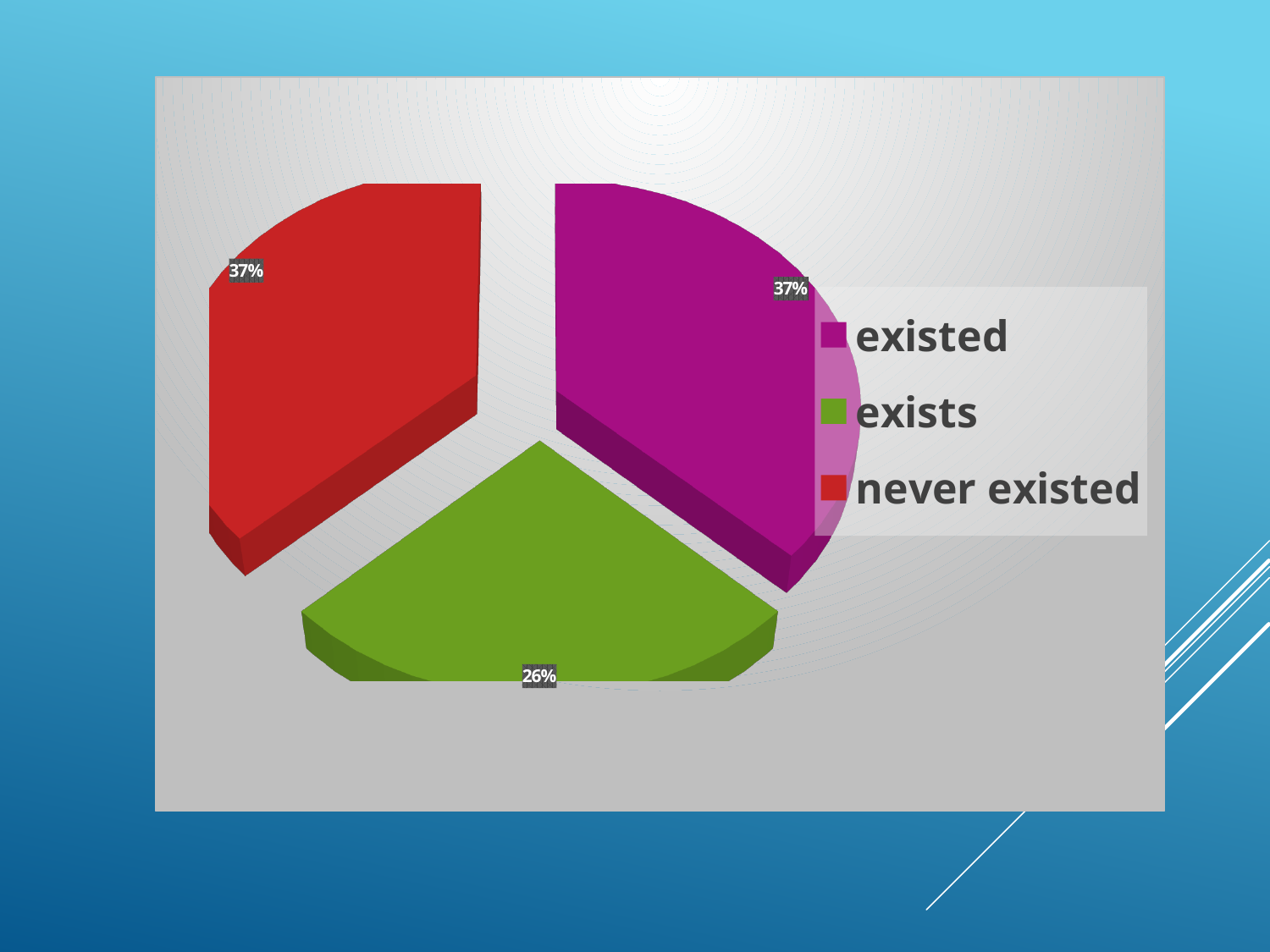
Which category has the smallest slice of the pie? exists Which is larger, the "existed" slice or the "exists" slice? existed What share of the pie does the "never existed" slice represent? 37% How many slices does the pie chart have? 3 What kind of chart is shown on the slide? pie chart Which is larger, the "never existed" slice or the "exists" slice? never existed Which category is shown in red? never existed What is the difference in percentage points between the "existed" slice and the "exists" slice? 11 What share of the pie does the "existed" slice represent? 37% What share of the pie does the "exists" slice represent? 26% What colour is the "exists" slice? green How many entries does the legend list? 3